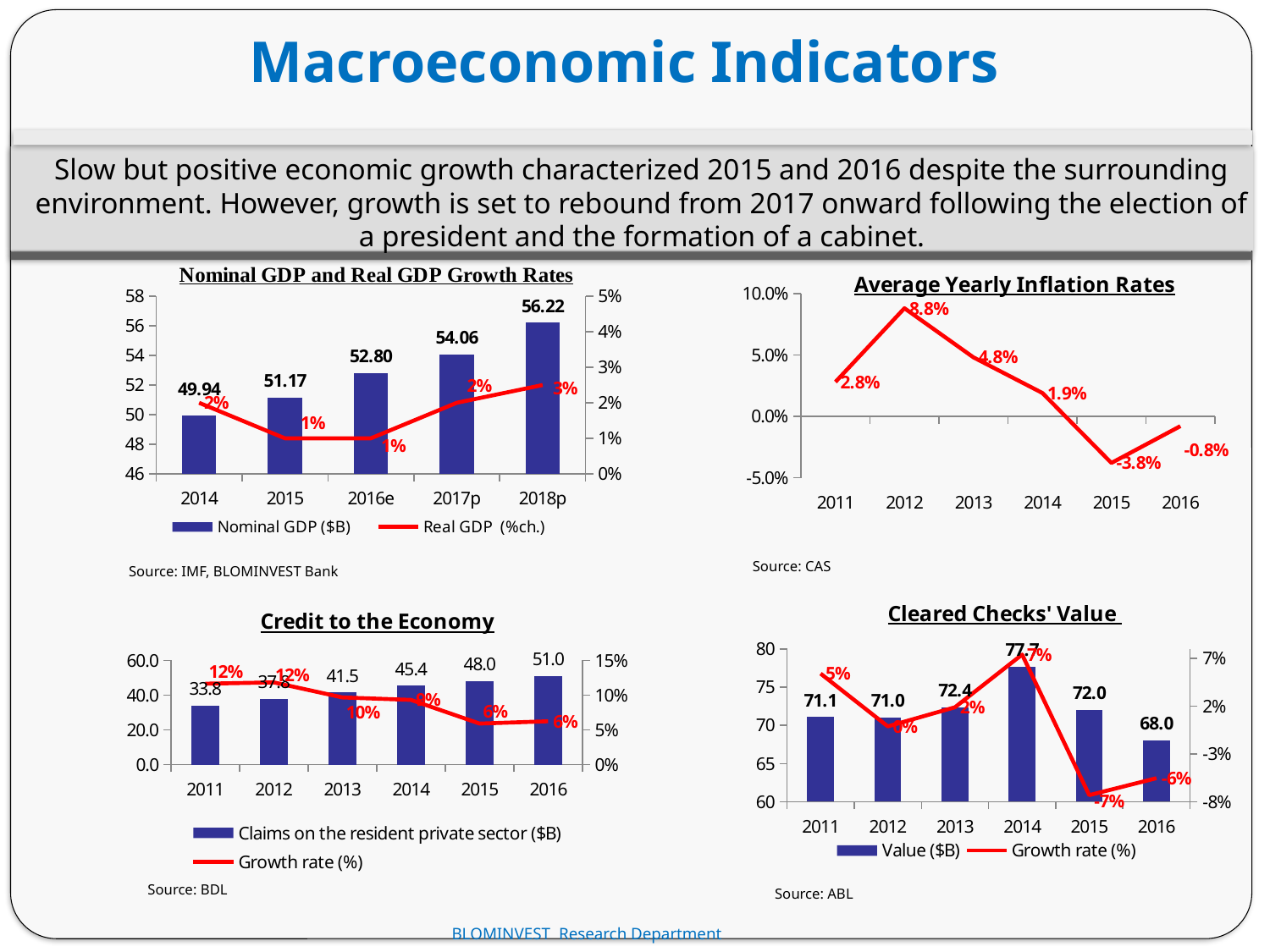
In the Cleared Checks' Value chart, what is the difference between the values for 2014 and 2015? 5.7 In the Nominal GDP and Real GDP Growth Rates chart, what is the difference between the nominal GDP values for 2017p and 2014? 4.12 In the Average Yearly Inflation Rates chart, how many years are plotted? 6 In the Nominal GDP and Real GDP Growth Rates chart, what is the nominal GDP value for 2018p? 56.22 In the Credit to the Economy chart, what is the value of claims on the resident private sector for 2016? 51.0 In the Nominal GDP and Real GDP Growth Rates chart, how many series does the legend list? 2 In the Cleared Checks' Value chart, which year has the lowest value? 2016 In the Average Yearly Inflation Rates chart, what is the inflation rate for 2015? -3.8% In the Credit to the Economy chart, do the bar values rise or fall from 2011 to 2016? Rise In the Average Yearly Inflation Rates chart, which year has the highest inflation rate? 2012 In the Cleared Checks' Value chart, which year has the highest value? 2014 In the Average Yearly Inflation Rates chart, what kind of chart is used? Line chart